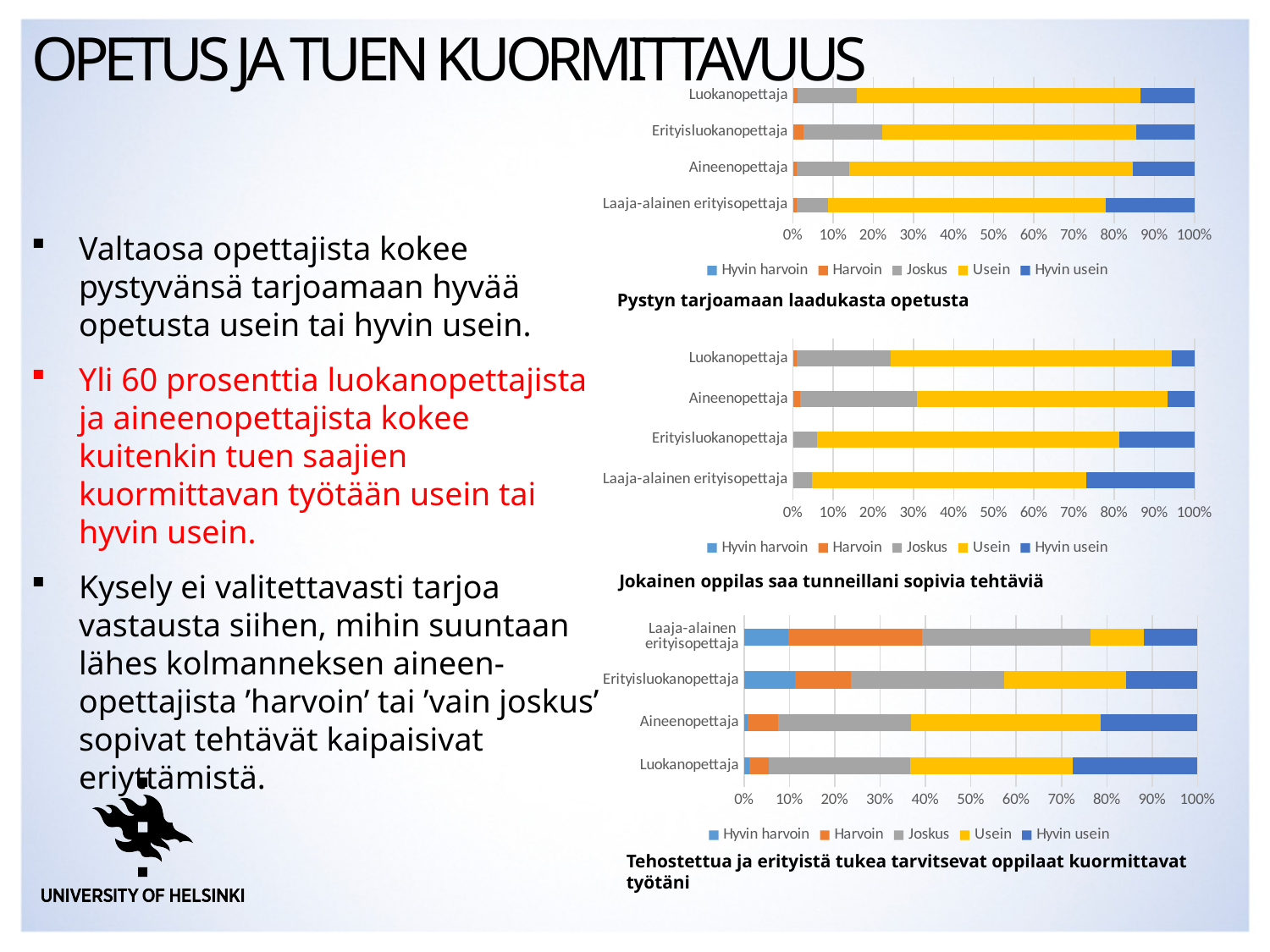
In the chart titled 'Tehostettua ja erityistä tukea tarvitsevat oppilaat kuormittavat työtäni', which category is listed at the top of the chart? Laaja-alainen erityisopettaja In the chart titled 'Jokainen oppilas saa tunneillani sopivia tehtäviä', which category has the largest 'Hyvin usein' segment? Laaja-alainen erityisopettaja What kind of chart is the chart titled 'Pystyn tarjoamaan laadukasta opetusta'? Stacked bar chart How many teacher categories are shown in the chart titled 'Jokainen oppilas saa tunneillani sopivia tehtäviä'? 4 How many series does the legend list in the chart titled 'Tehostettua ja erityistä tukea tarvitsevat oppilaat kuormittavat työtäni'? 5 In the chart titled 'Pystyn tarjoamaan laadukasta opetusta', is the 'Hyvin usein' segment for Laaja-alainen erityisopettaja greater or less than 10%? greater In the chart titled 'Tehostettua ja erityistä tukea tarvitsevat oppilaat kuormittavat työtäni', which category has the largest 'Harvoin' segment? Laaja-alainen erityisopettaja In the chart titled 'Pystyn tarjoamaan laadukasta opetusta', what are the legend entries? Hyvin harvoin, Harvoin, Joskus, Usein, Hyvin usein In the chart titled 'Tehostettua ja erityistä tukea tarvitsevat oppilaat kuormittavat työtäni', which is larger: the 'Harvoin' segment for Laaja-alainen erityisopettaja or the 'Harvoin' segment for Luokanopettaja? Laaja-alainen erityisopettaja In the chart titled 'Jokainen oppilas saa tunneillani sopivia tehtäviä', is the 'Hyvin usein' segment for Luokanopettaja greater or less than 10%? less In the chart titled 'Tehostettua ja erityistä tukea tarvitsevat oppilaat kuormittavat työtäni', is the 'Hyvin usein' segment for Luokanopettaja greater or less than 20%? greater